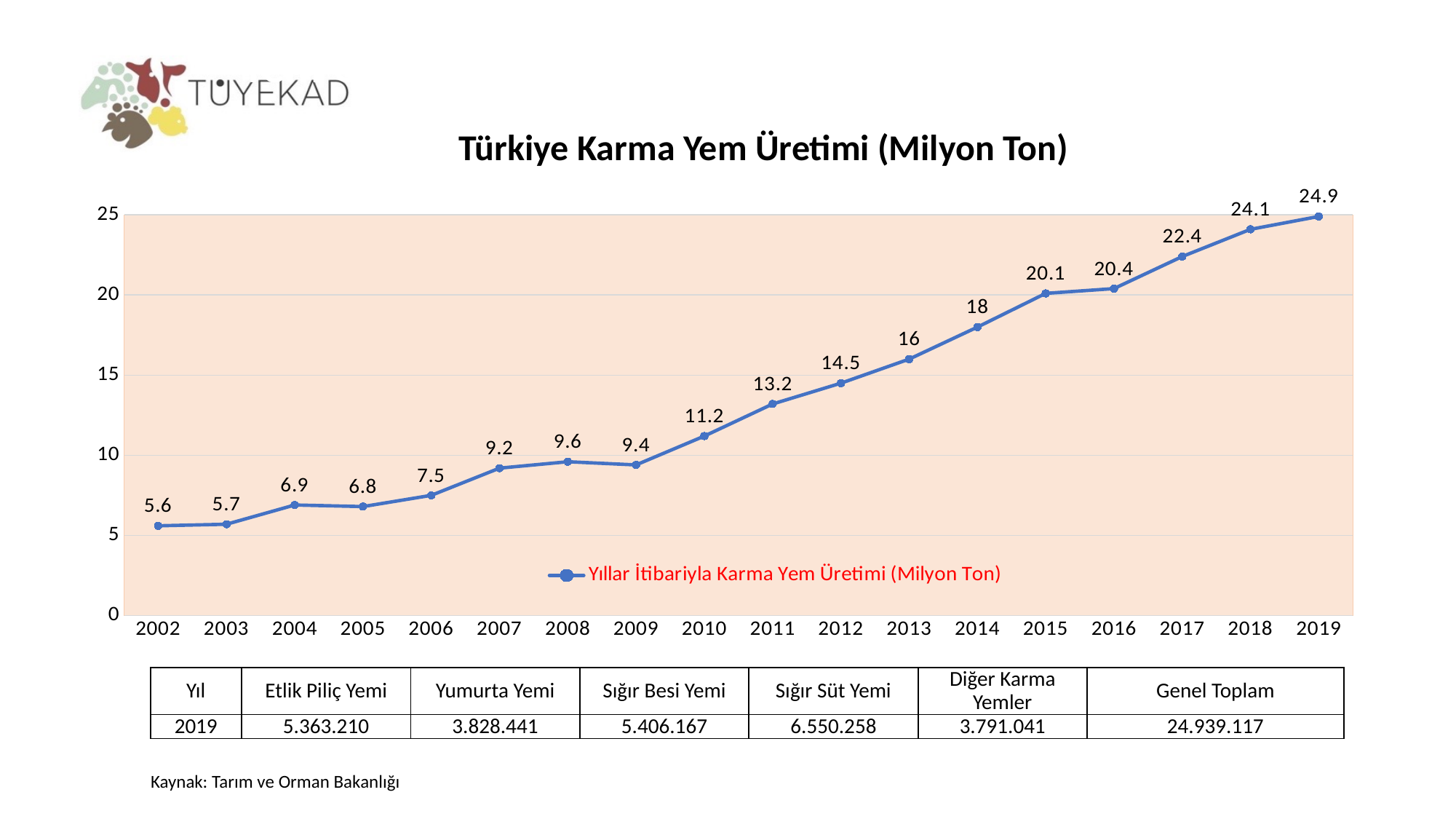
What is the value for 2002 in the chart? 5.6 Do the values generally rise or fall from 2002 to 2019? rise What is the value for 2010 in the chart? 11.2 How many series does the legend list? 1 What is the difference between the values for 2015 and 2014? 2.1 How many years are plotted on the x axis of the chart? 18 Which is larger, the value for 2008 or the value for 2009? 2008 Which year has the lowest value in the chart? 2002 Which year has the highest value in the chart? 2019 What kind of chart is shown on the slide? line chart What is the value for 2019 in the chart? 24.9 What is the difference between the values for 2019 and 2002? 19.3